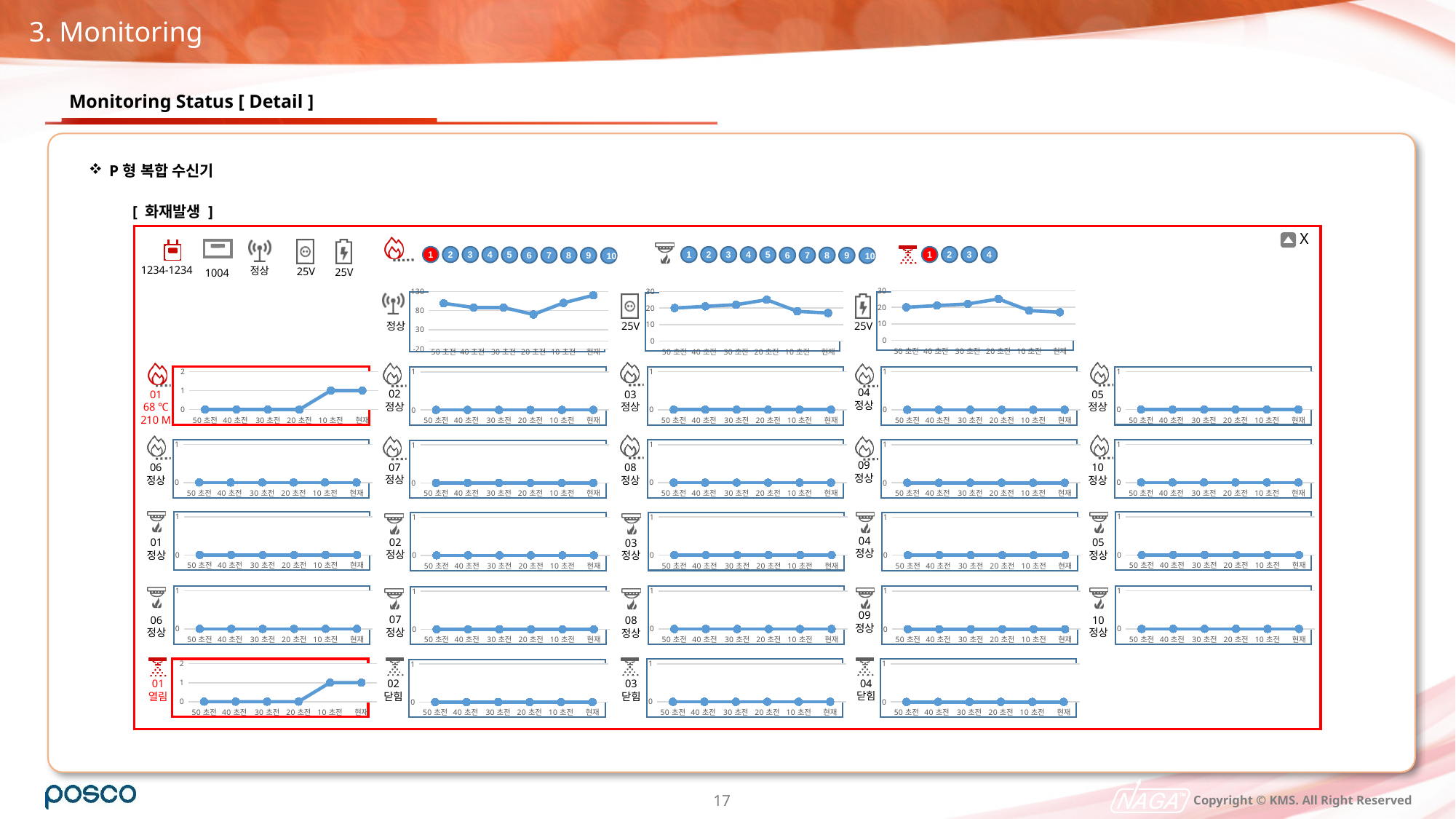
In the heat detector 01 chart (red-bordered), what is the value at 50 초전? 0 In the top-left signal chart (labelled 정상), at which time point is the value lowest? 20 초전 How many sprinkler charts are shown in the bottom row of the dashboard? 4 How many time points are plotted along the x axis of the heat detector 01 chart? 6 In the top-middle chart (labelled 25V), is the value at 20 초전 greater or less than 20? greater In the heat detector 01 chart (red-bordered), do the values rise or fall from 50 초전 to 현재? rise In the sprinkler 01 chart (red-bordered, bottom left), what is the value at 20 초전? 0 What kind of chart is used for the heat detector 01 panel (red-bordered, left of the fourth row)? line chart In the top-left signal chart (labelled 정상), is the value at 현재 greater or less than 80? greater In the top-middle chart (labelled 25V), at which time point is the value highest? 20 초전 In the heat detector 01 chart (red-bordered), what is the value at 현재? 1 In the sprinkler 01 chart (red-bordered, bottom left), what is the value at 10 초전? 1